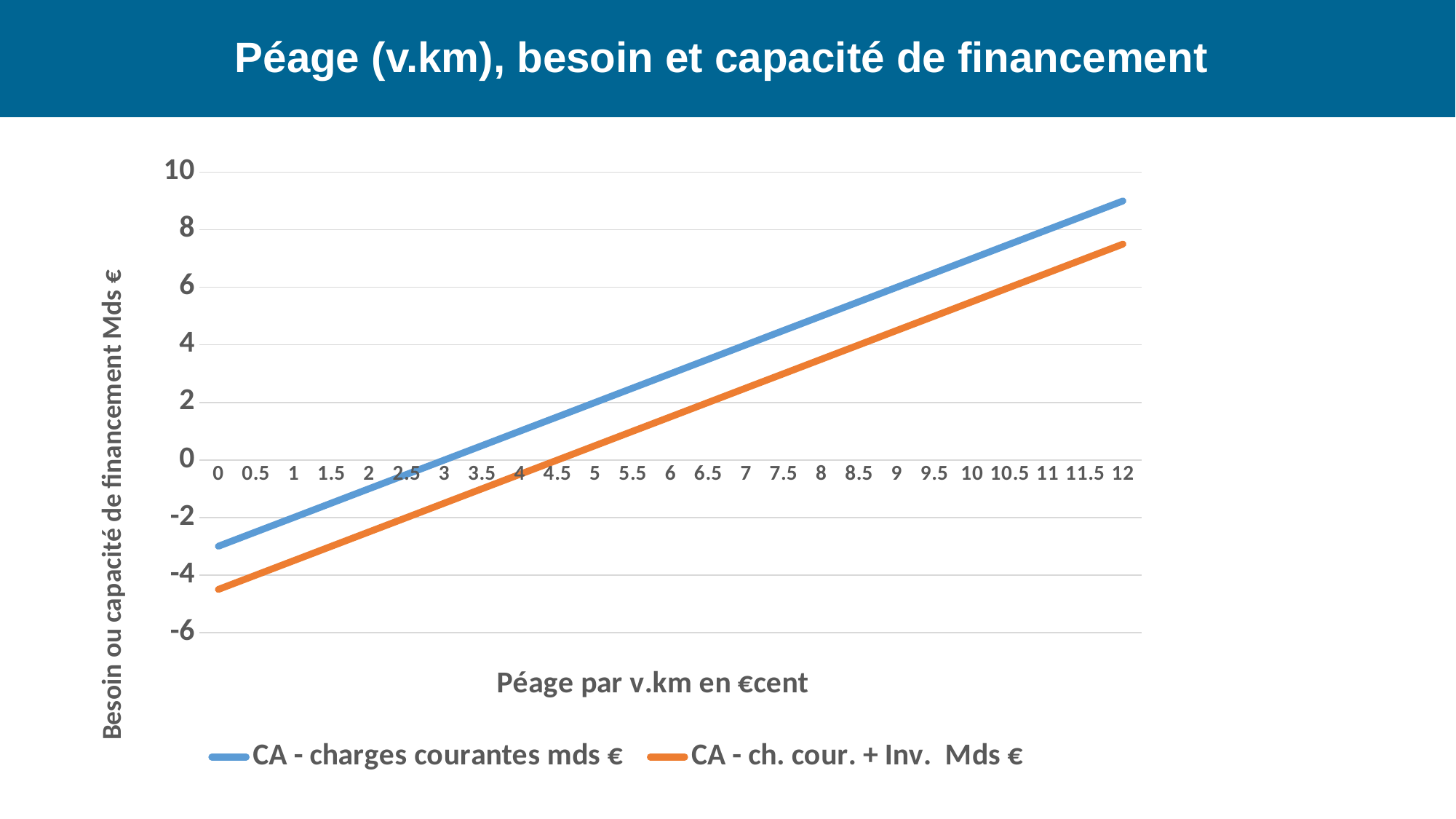
How many points are marked along the x axis? 25 At a toll of 12 €cent per v.km, which series has the higher value: 'CA - charges courantes mds €' or 'CA - ch. cour. + Inv. Mds €'? CA - charges courantes mds € At a toll of 0 €cent per v.km, which series has the lower value? CA - ch. cour. + Inv. Mds € What is the label of the x axis? Péage par v.km en €cent Do the values of the 'CA - charges courantes mds €' series rise or fall as the toll per v.km increases? rise Is the value of 'CA - ch. cour. + Inv. Mds €' at a toll of 12 €cent greater or less than 8? less How many series does the legend list? 2 What is the title of the chart? Péage (v.km), besoin et capacité de financement Is the value of 'CA - charges courantes mds €' at a toll of 12 €cent greater or less than 8? greater Do the values of the 'CA - ch. cour. + Inv. Mds €' series rise or fall along the x axis? rise What kind of chart is shown on the slide? line chart Is the value of 'CA - ch. cour. + Inv. Mds €' at a toll of 0 €cent greater or less than -4? less